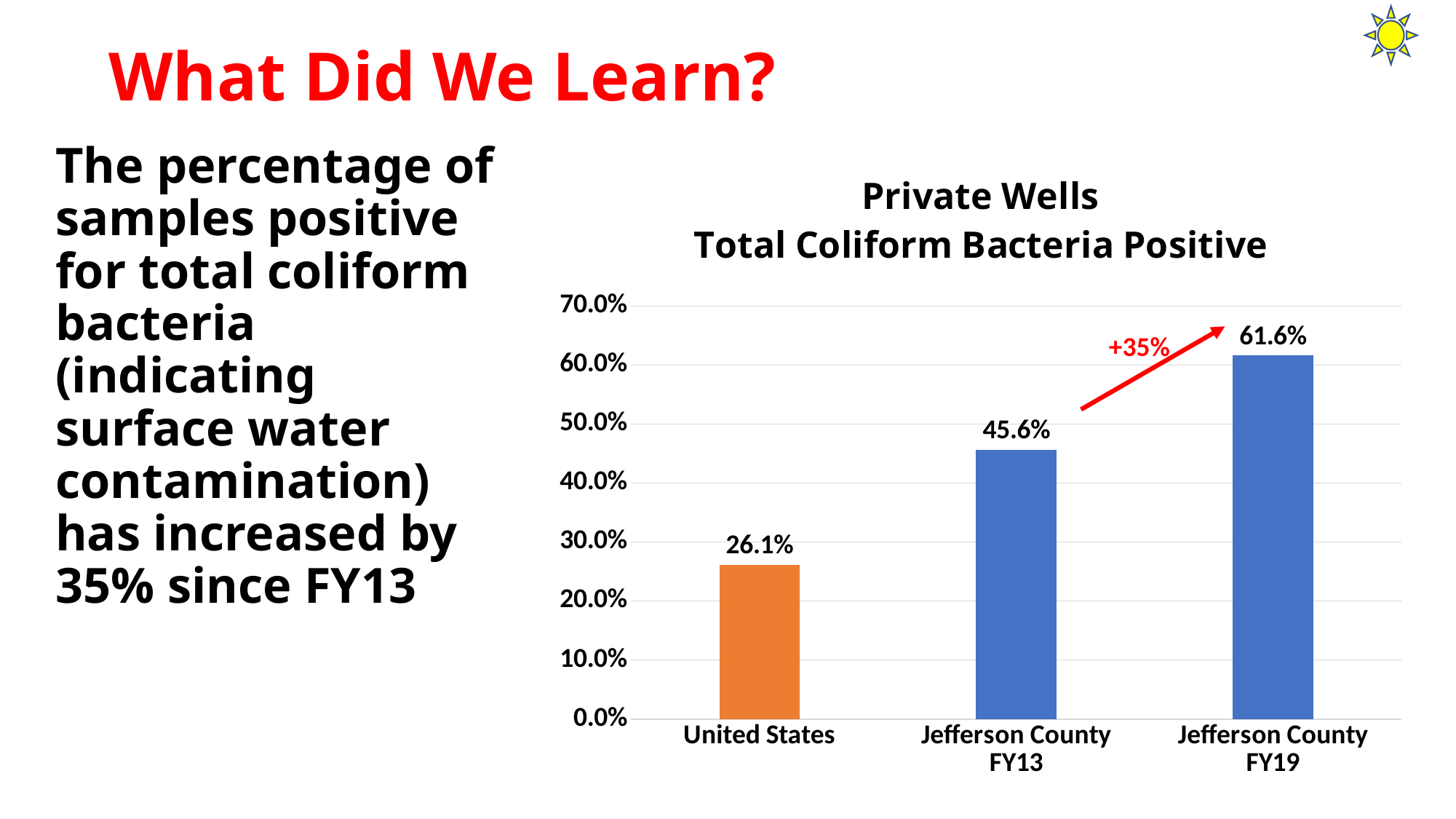
Is the value for Jefferson County FY19 greater or less than 60.0%? greater What is the value for Jefferson County FY13? 45.6% What is the difference between the Jefferson County FY13 and United States values? 19.5% What is the title of the chart? Private Wells Total Coliform Bacteria Positive What kind of chart is shown on the slide? bar chart How many categories are shown on the chart? 3 Which category has the highest value? Jefferson County FY19 What is the value for United States? 26.1% Which is larger, the value for United States or the value for Jefferson County FY13? Jefferson County FY13 What is the difference between the Jefferson County FY19 and Jefferson County FY13 values? 16.0% Which category has the lowest value? United States What is the value for Jefferson County FY19? 61.6%